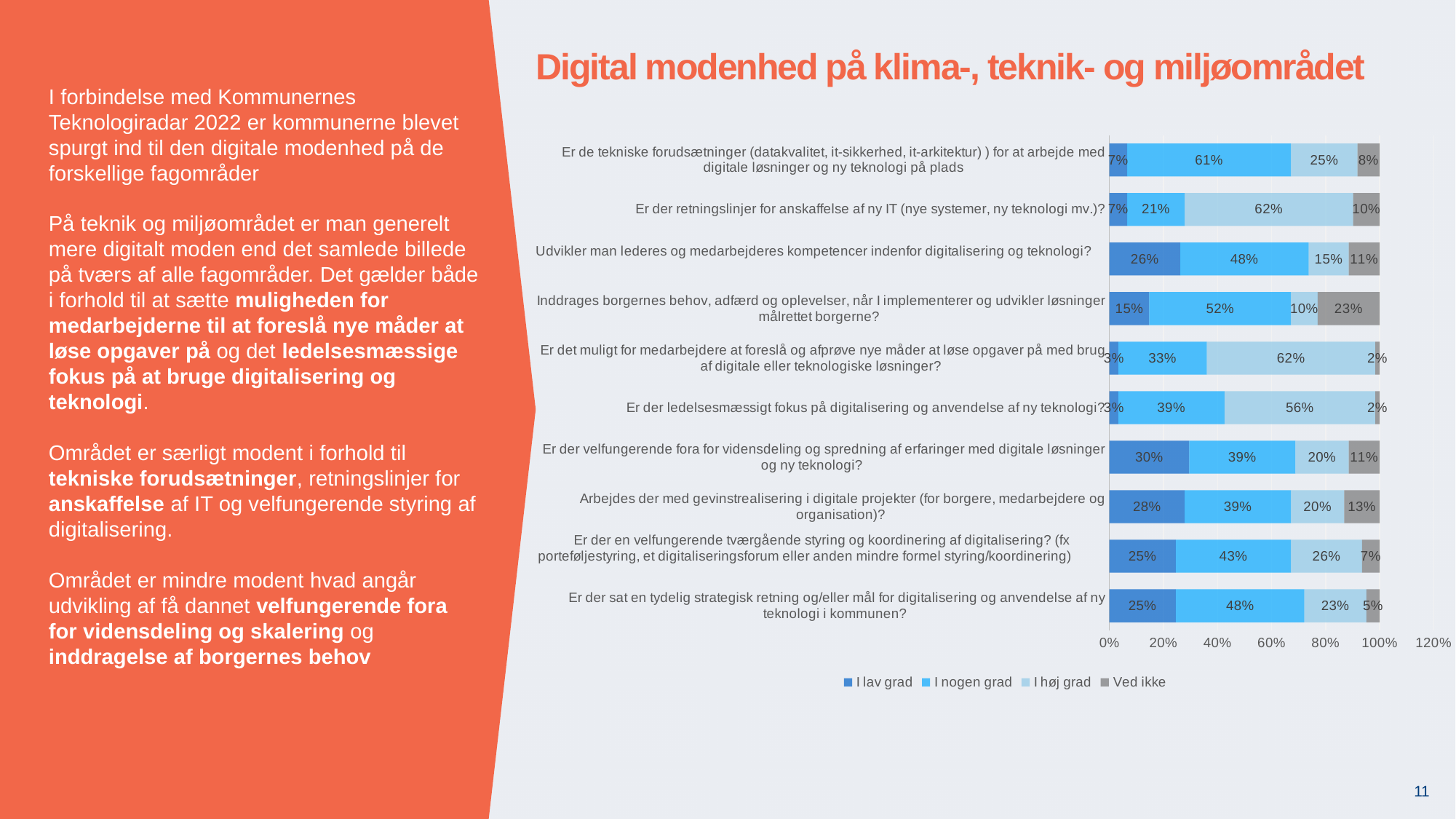
What share answered 'I lav grad' to 'Er der velfungerende fora for vidensdeling og spredning af erfaringer med digitale løsninger og ny teknologi?' 30% Which question has the highest 'Ved ikke' share? Inddrages borgernes behov, adfærd og oplevelser, når I implementerer og udvikler løsninger målrettet borgerne? What is the total of the stacked bar for 'Udvikler man lederes og medarbejderes kompetencer indenfor digitalisering og teknologi?'? 100% What is the difference between the 'I høj grad' share for 'Er der ledelsesmæssigt fokus på digitalisering og anvendelse af ny teknologi?' and for 'Udvikler man lederes og medarbejderes kompetencer indenfor digitalisering og teknologi?'? 41% How many series does the legend list? 4 Which is larger: the 'I lav grad' share for 'Arbejdes der med gevinstrealisering i digitale projekter' or for 'Er der sat en tydelig strategisk retning og/eller mål for digitalisering'? Arbejdes der med gevinstrealisering i digitale projekter How many questions (categories) are shown in the chart? 10 Which question has the highest 'I nogen grad' share? Er de tekniske forudsætninger (datakvalitet, it-sikkerhed, it-arkitektur) ) for at arbejde med digitale løsninger og ny teknologi på plads What kind of chart is shown on the slide? Stacked bar chart What share answered 'I høj grad' to 'Er der retningslinjer for anskaffelse af ny IT (nye systemer, ny teknologi mv.)?' 62% What share answered 'Ved ikke' to 'Inddrages borgernes behov, adfærd og oplevelser, når I implementerer og udvikler løsninger målrettet borgerne?' 23% What share answered 'I nogen grad' to 'Er de tekniske forudsætninger ... for at arbejde med digitale løsninger og ny teknologi på plads'? 61%